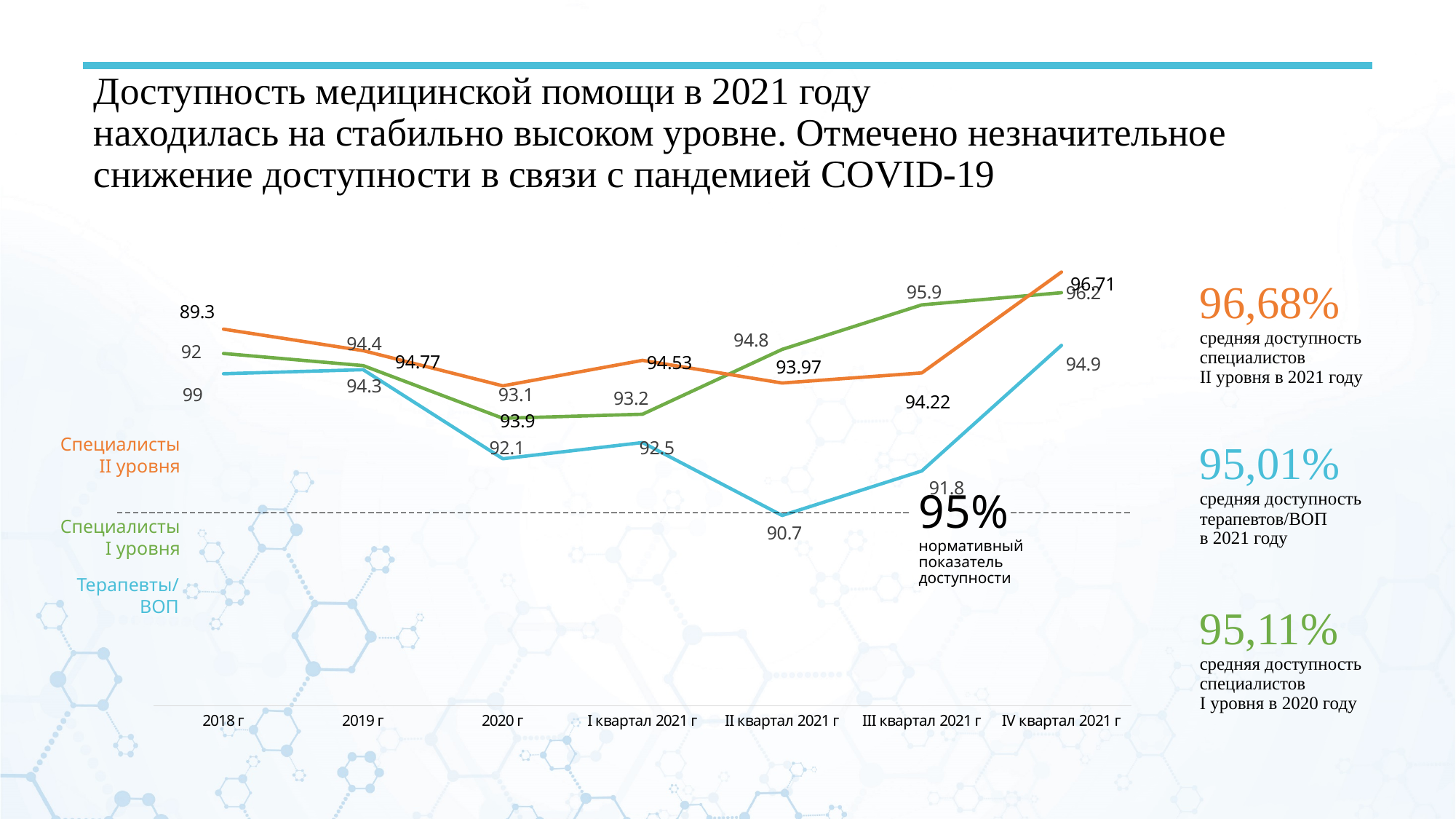
What is the value for Специалисты I уровня in IV квартал 2021 г? 96.2 What is the value for Специалисты I уровня in III квартал 2021 г? 95.9 Does the Терапевты/ВОП series rise or fall from II квартал 2021 г to IV квартал 2021 г? rise What kind of chart is shown on the slide? line chart What is the value for Терапевты/ВОП in II квартал 2021 г? 90.7 What value does the dashed line labelled нормативный показатель доступности mark on the chart? 95% How many series are plotted on the chart? 3 In which period does the Терапевты/ВОП series reach its lowest value? II квартал 2021 г In IV квартал 2021 г, what is the difference between Специалисты II уровня and Терапевты/ВОП? 1.81 What is the value for Специалисты II уровня in IV квартал 2021 г? 96.71 In IV квартал 2021 г, which series is higher: Специалисты II уровня or Специалисты I уровня? Специалисты II уровня How many categories are shown along the x axis of the chart? 7